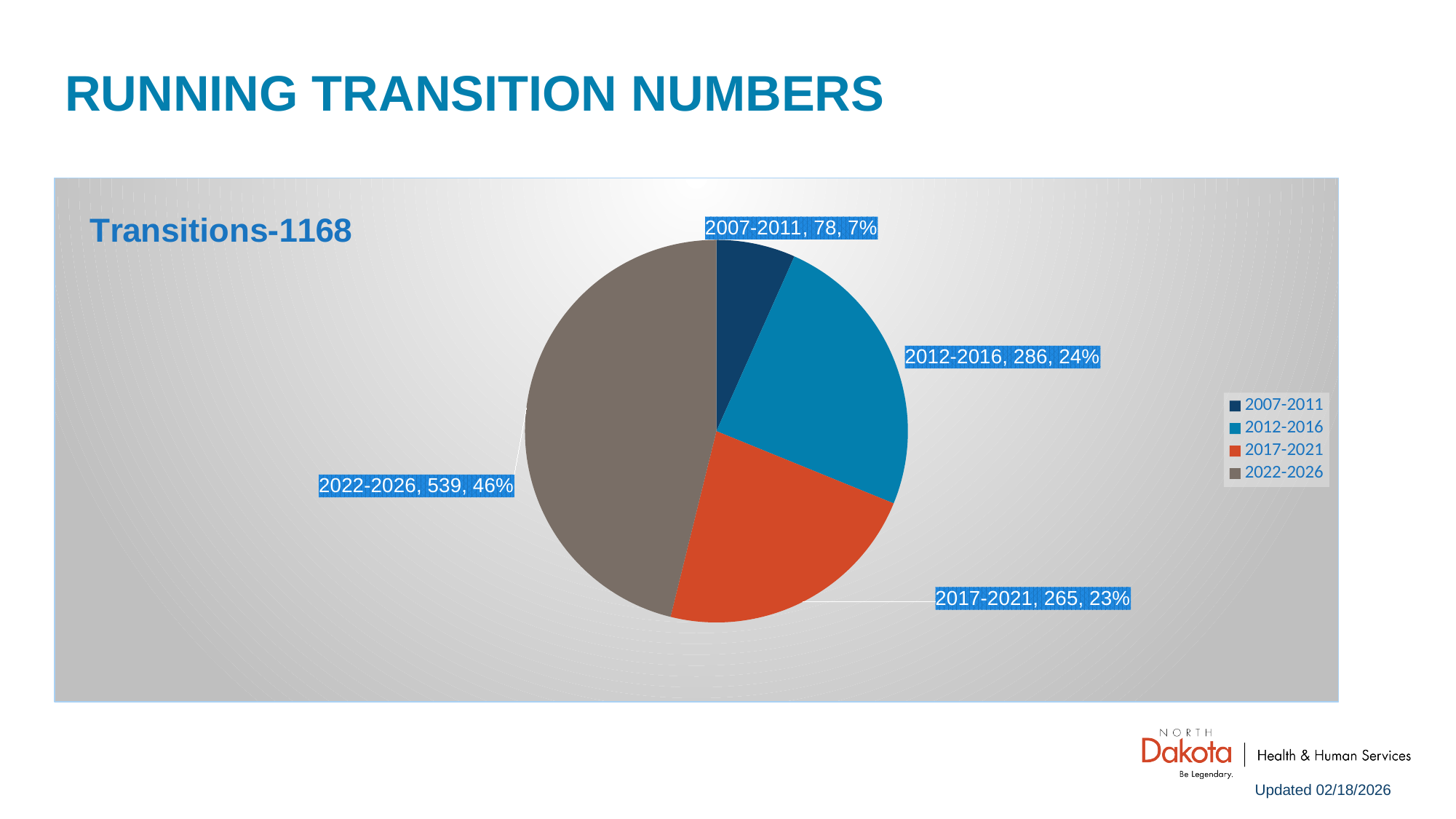
What is the value for 2012-2016? 286 Which is larger, the value for 2012-2016 or the value for 2007-2011? 2012-2016 What is the value for 2007-2011? 78 How many entries does the legend list? 4 What is the chart's title? Transitions-1168 How many slices does the pie chart have? 4 Which period has the largest slice? 2022-2026 What is the value for 2022-2026? 539 What is the difference between the values for 2022-2026 and 2012-2016? 253 What share of the pie does 2017-2021 represent? 23% Which period has the smallest slice? 2007-2011 What type of chart is shown on the slide? pie chart